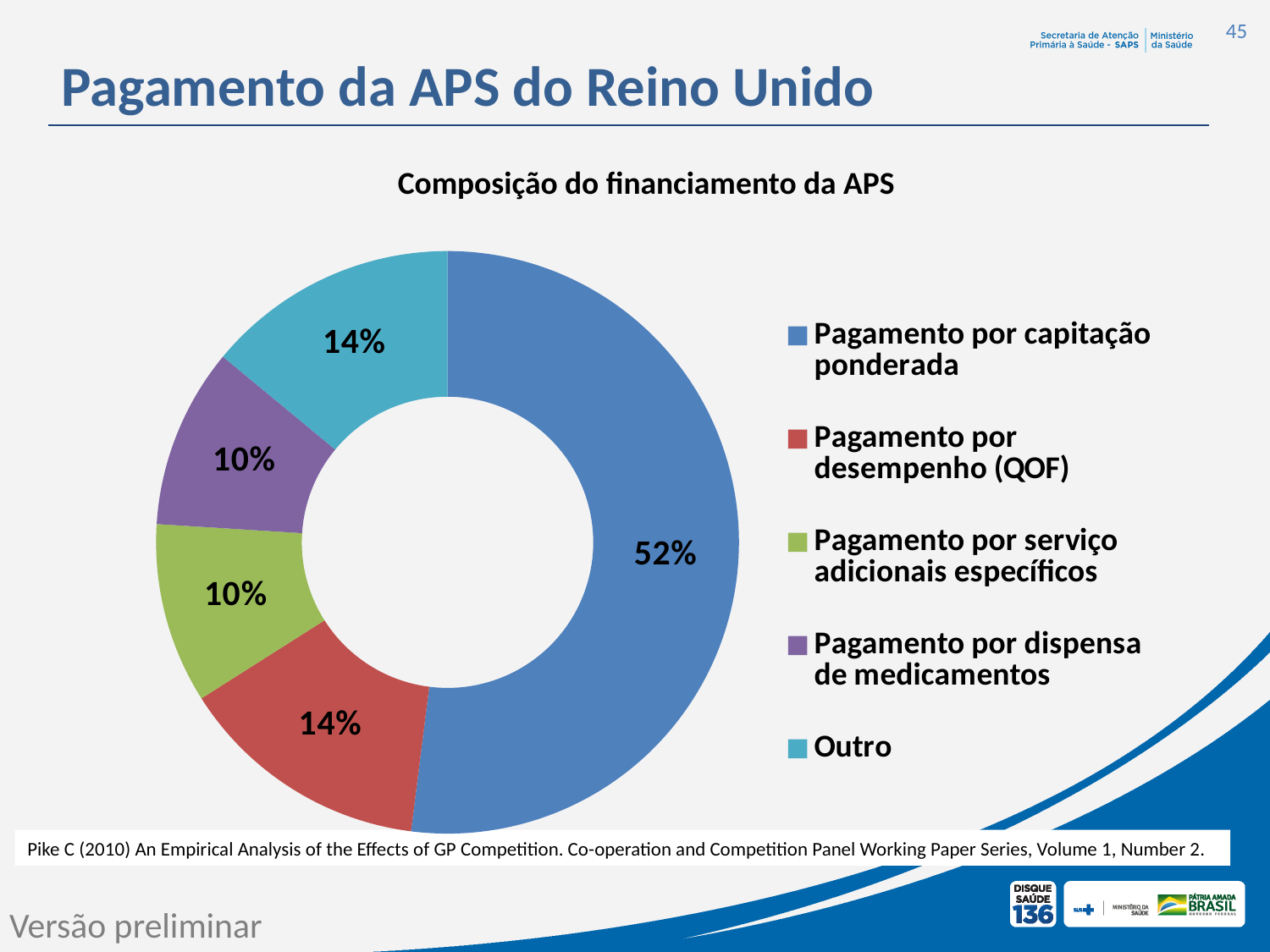
What kind of chart is shown on the slide? Doughnut (pie) chart What share of the chart does 'Outro' represent? 14% What share of the chart does 'Pagamento por desempenho (QOF)' represent? 14% What is the title of the chart? Composição do financiamento da APS What share of the chart does 'Pagamento por dispensa de medicamentos' represent? 10% What colour is the slice for 'Outro'? Teal (light blue) What is the difference in percentage points between 'Pagamento por capitação ponderada' and 'Outro'? 38 What is the combined share of 'Pagamento por serviço adicionais específicos' and 'Pagamento por dispensa de medicamentos'? 20% How many categories does the chart show? 5 Which is larger: the share for 'Pagamento por desempenho (QOF)' or the share for 'Pagamento por serviço adicionais específicos'? Pagamento por desempenho (QOF) What share of the chart does 'Pagamento por capitação ponderada' represent? 52% Which category has the largest share of the chart? Pagamento por capitação ponderada